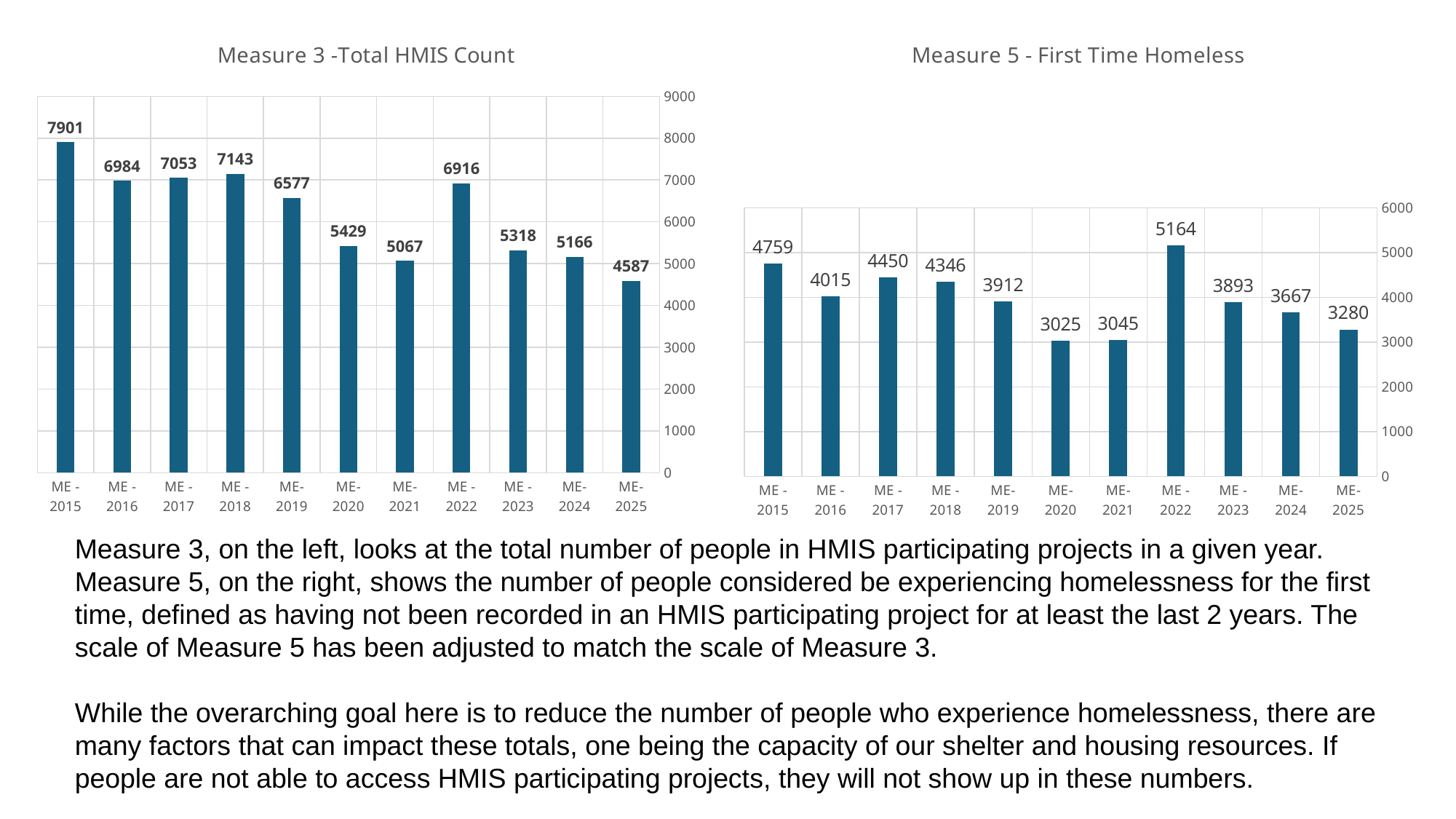
In the Measure 3 - Total HMIS Count chart, what is the value for ME - 2015? 7901 What type of chart is the Measure 5 - First Time Homeless chart? bar chart In the Measure 5 - First Time Homeless chart, what is the difference between the values for ME - 2022 and ME - 2021? 2119 In the Measure 3 - Total HMIS Count chart, what is the value for ME - 2025? 4587 In the Measure 5 - First Time Homeless chart, what is the value for ME - 2022? 5164 In the Measure 3 - Total HMIS Count chart, what is the difference between the values for ME - 2015 and ME - 2025? 3314 In the Measure 3 - Total HMIS Count chart, which is larger: the value for ME - 2018 or ME - 2022? ME - 2018 In the Measure 5 - First Time Homeless chart, is the value for ME - 2019 greater or less than 4000? less In the Measure 5 - First Time Homeless chart, which year has the lowest value? ME - 2020 How many years are shown in the Measure 3 - Total HMIS Count chart? 11 In the Measure 3 - Total HMIS Count chart, do the values rise or fall from ME - 2022 to ME - 2025? fall In the Measure 3 - Total HMIS Count chart, which year has the highest value? ME - 2015